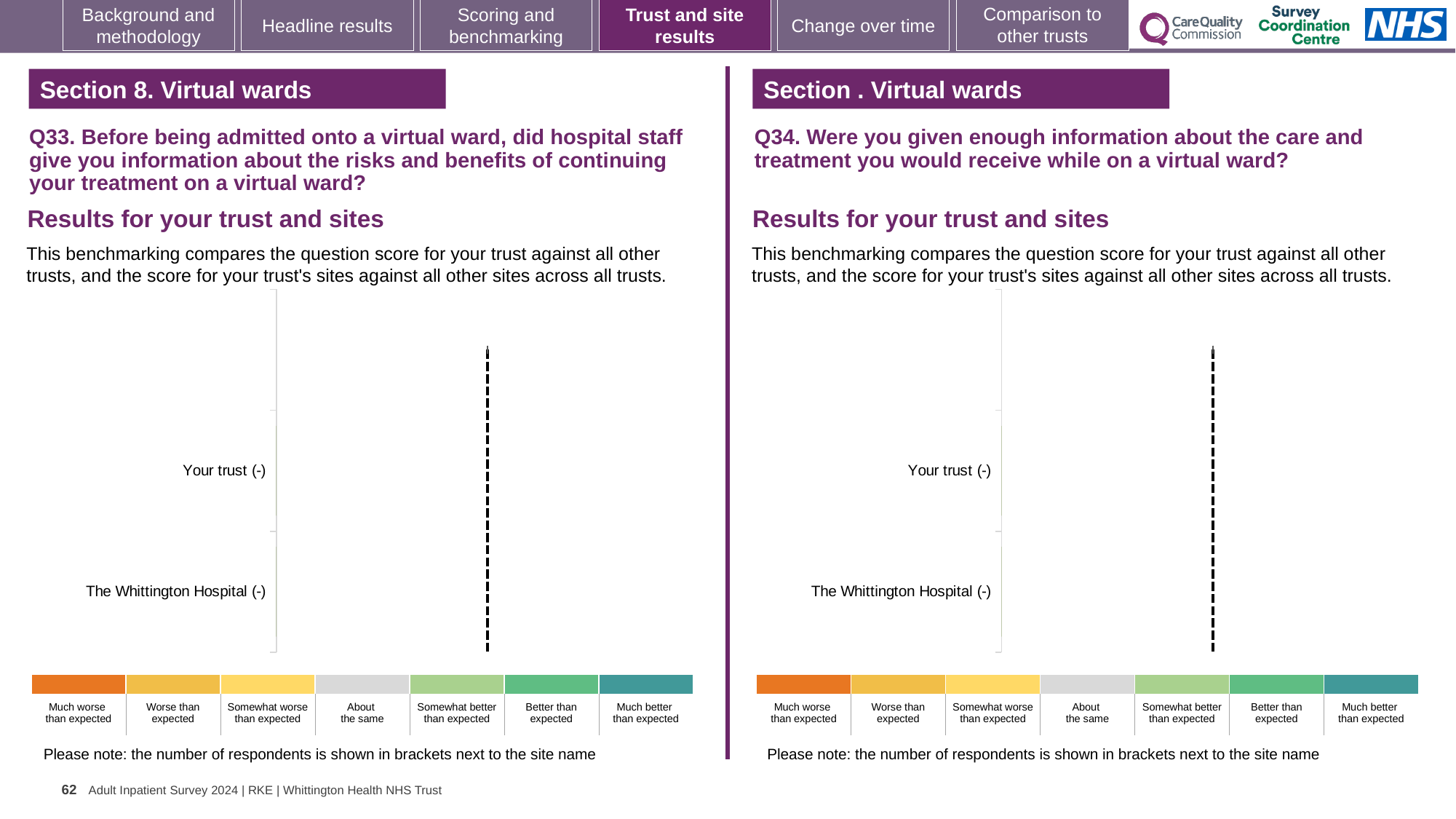
On the Q34 chart (right), how many colour bands are shown in the key below the chart? 7 On the Q34 chart (right), what is the label of the first category on the vertical axis? Your trust (-) On the Q33 chart (left), what is the label of the second category on the vertical axis? The Whittington Hospital (-) On the Q33 chart (left), what number of respondents is shown in brackets next to 'Your trust'? - On the Q34 chart (right), what number of respondents is shown in brackets next to 'The Whittington Hospital'? - On the Q33 chart (left), how many categories are listed on the vertical axis? 2 On the Q34 chart (right), how many categories are listed on the vertical axis? 2